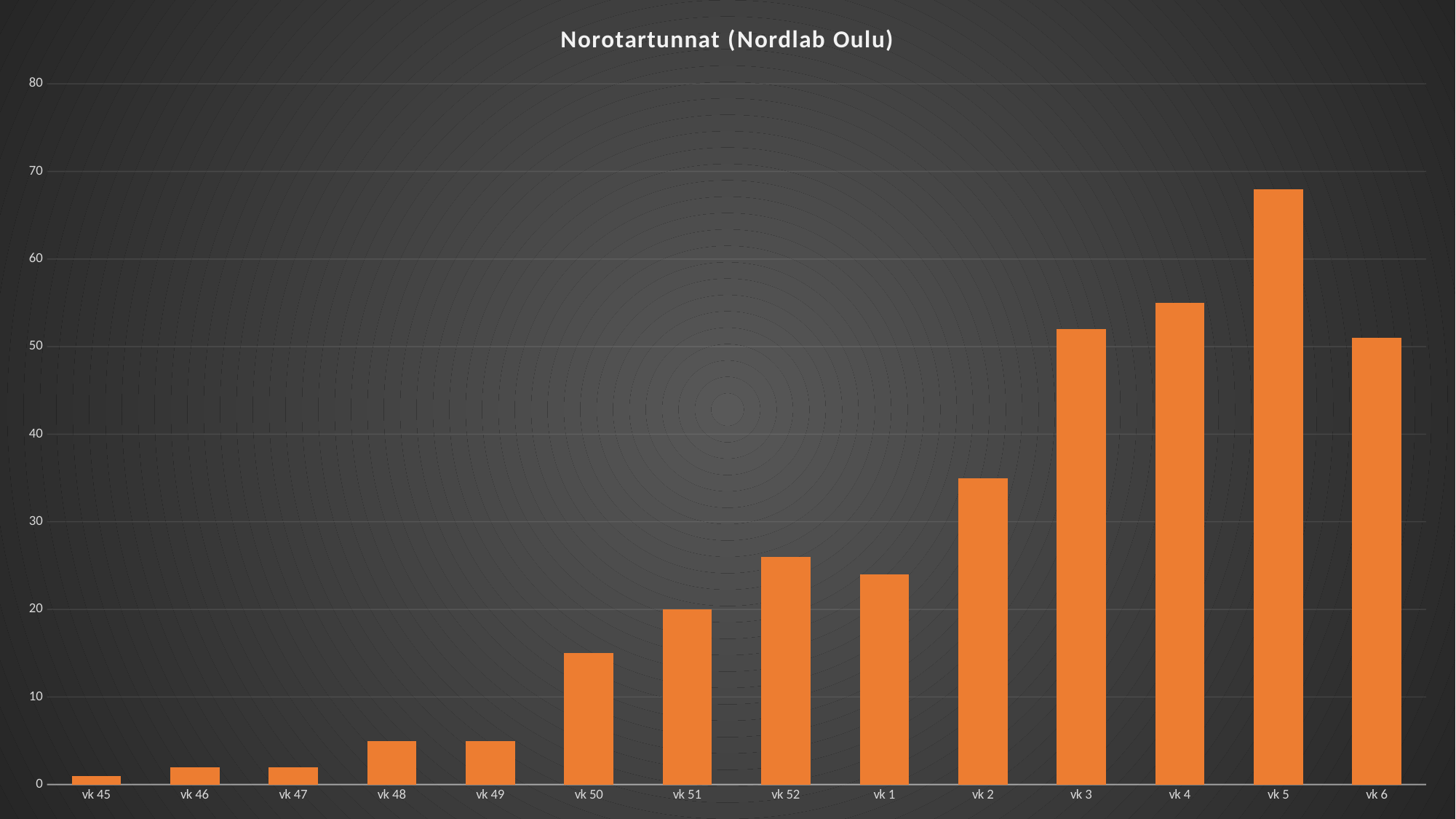
Which week has the lowest value? vk 45 What kind of chart is shown on the slide? bar chart Which is larger, the value for vk 52 or the value for vk 1? vk 52 Is the value for vk 2 greater or less than 40? less Is the value for vk 48 greater or less than 10? less Which is larger, the value for vk 4 or the value for vk 6? vk 4 What is the title of the chart? Norotartunnat (Nordlab Oulu) Is the value for vk 5 greater or less than 60? greater Do the values generally rise or fall from vk 45 to vk 5? rise Which week has the highest value? vk 5 How many weeks (categories) are shown on the x axis? 14